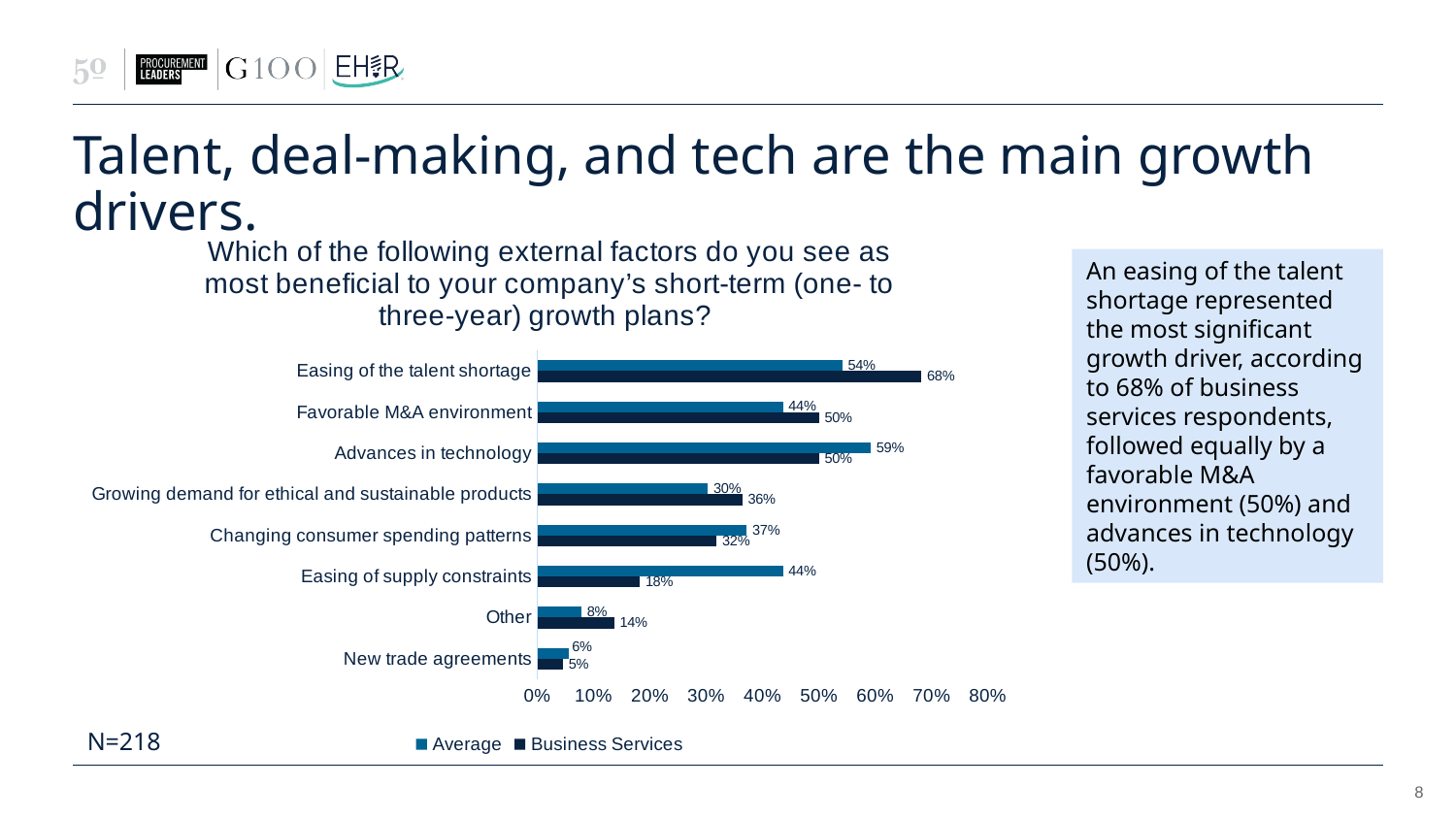
What is the difference between the Business Services and Average values for 'Easing of the talent shortage'? 14% For 'Easing of supply constraints', which is larger: the Average value or the Business Services value? Average What is the Business Services value for 'Easing of supply constraints'? 18% How many series does the legend list? 2 What kind of chart is shown on the slide? Bar chart What is the Average value for 'Advances in technology'? 59% How many external factors (categories) are plotted in the chart? 8 What is the difference between the Average and Business Services values for 'Easing of supply constraints'? 26% What is the sample size (N) stated on the slide? N=218 Which category has the lowest Average value? New trade agreements What is the Business Services value for 'Easing of the talent shortage'? 68% Which category has the highest Business Services value? Easing of the talent shortage